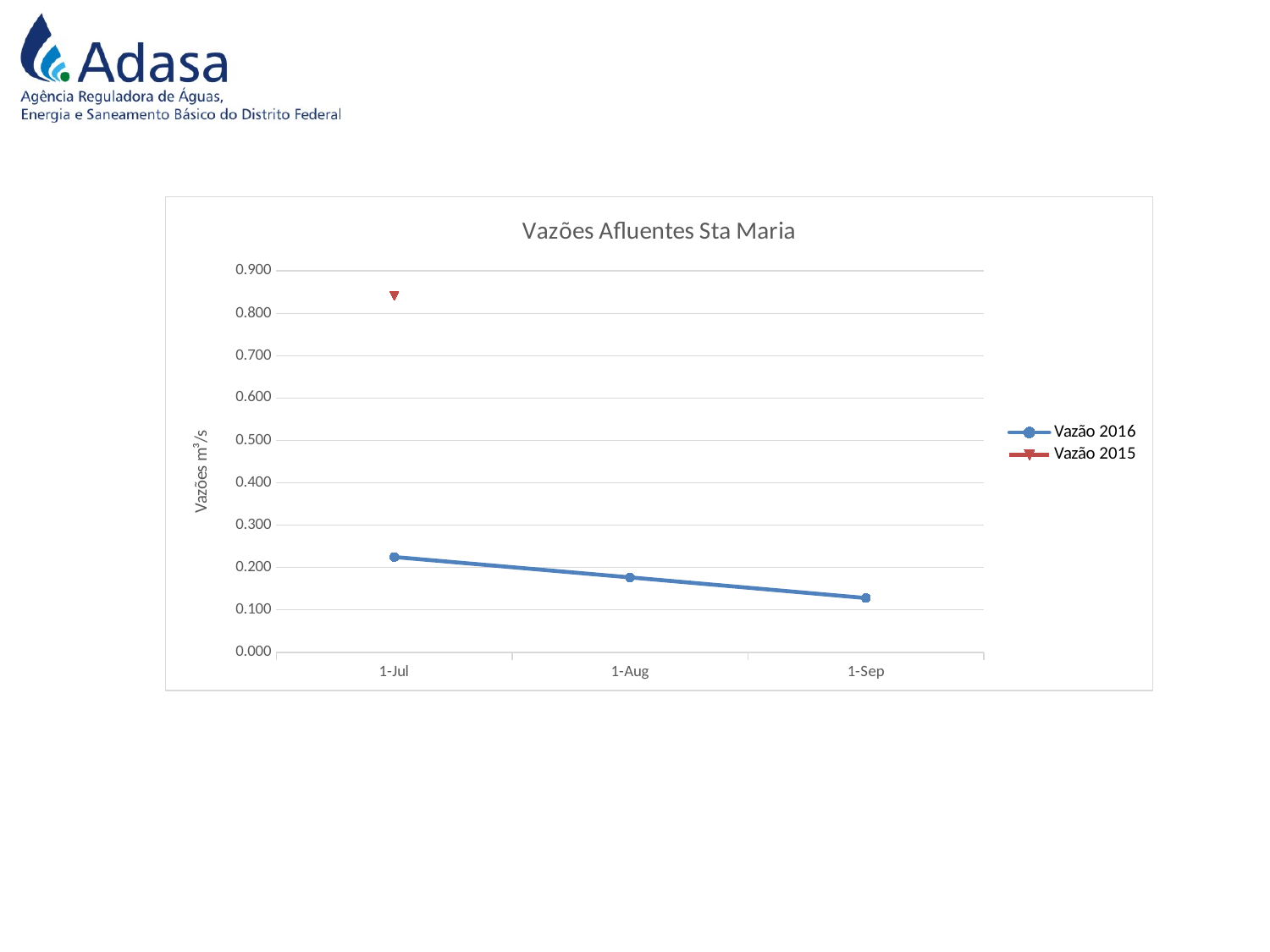
What is the title of the chart? Vazões Afluentes Sta Maria What kind of chart is shown on the slide? line chart Is the Vazão 2016 value for 1-Jul greater or less than 0.300? less How many points are plotted for the Vazão 2016 series? 3 What is the label of the vertical axis? Vazões m³/s Does the Vazão 2016 series rise or fall from 1-Jul to 1-Sep? fall How many series does the legend list? 2 Is the Vazão 2015 value for 1-Jul greater or less than 0.800? greater Which series has the higher value at 1-Jul, Vazão 2016 or Vazão 2015? Vazão 2015 Is the Vazão 2016 value for 1-Sep greater or less than 0.100? greater At which date is the Vazão 2016 series highest? 1-Jul At which date is the Vazão 2016 series lowest? 1-Sep